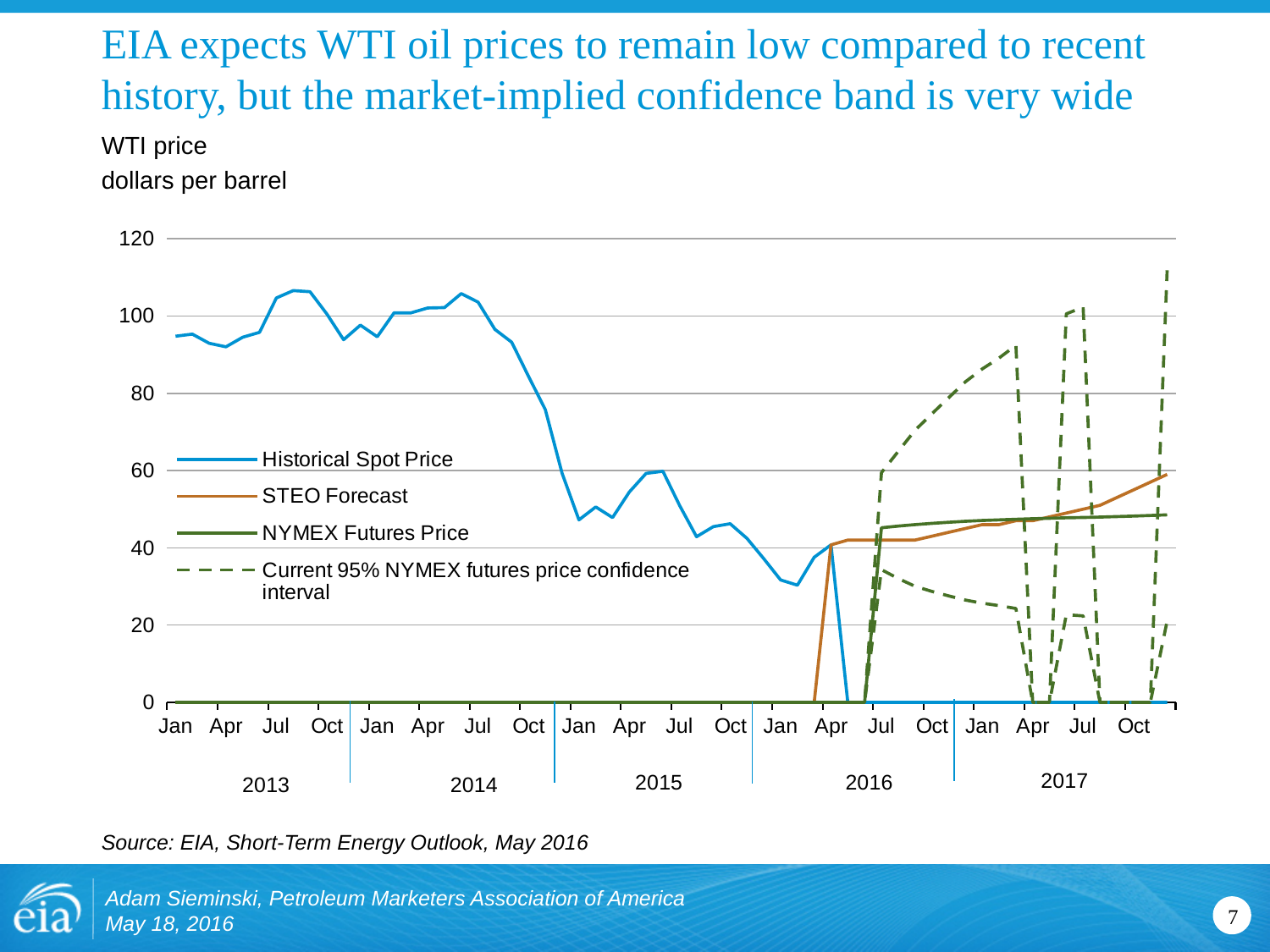
How many series does the legend list? 4 Is the peak of the Historical Spot Price in mid-2014 greater or less than 100? greater What kind of chart is shown on the slide? line chart Is the Historical Spot Price in Jan 2013 greater or less than 80? greater Which series is drawn with a dashed line? Current 95% NYMEX futures price confidence interval Does the Historical Spot Price rise or fall between mid-2014 and early 2016? fall How many years are labelled along the x axis? 5 Is the Historical Spot Price in Jan 2016 greater or less than 40? less What unit is the WTI price plotted in, according to the axis label? dollars per barrel At the end of 2017, which is higher: the STEO Forecast or the NYMEX Futures Price? STEO Forecast